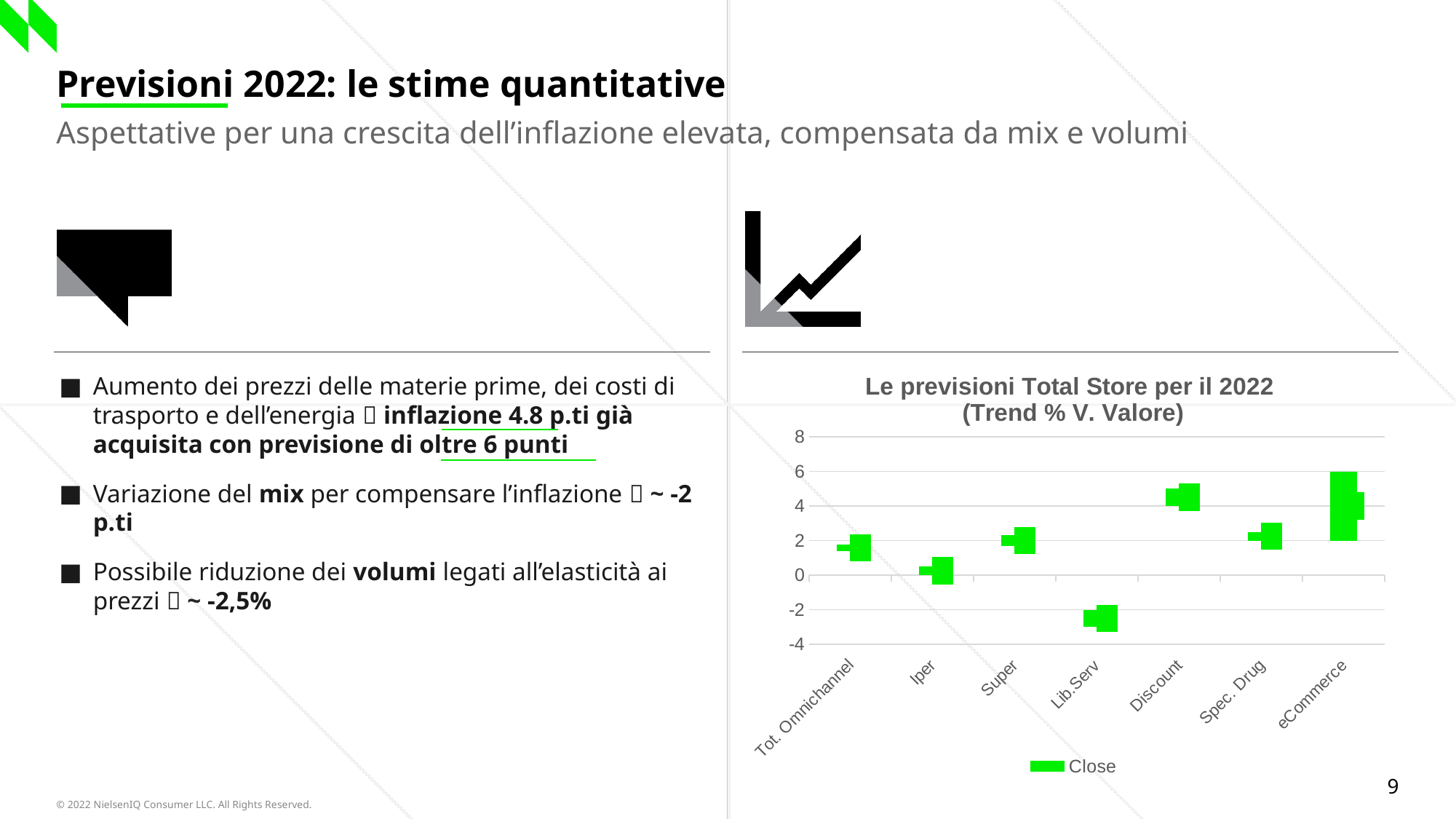
Is the value for Tot. Omnichannel greater or less than 0? greater What is the name of the series listed in the chart legend? Close Is the value for eCommerce greater or less than 2? greater How many categories are shown on the x axis of the chart? 7 Which category has the highest value in the chart? eCommerce Which is larger, the value for Discount or the value for Super? Discount Which category has the lowest value in the chart? Lib.Serv Is the value for Discount greater or less than 2? greater How many series does the chart legend list? 1 What is the title of the chart? Le previsioni Total Store per il 2022 (Trend % V. Valore) Which is larger, the value for Iper or the value for Lib.Serv? Iper